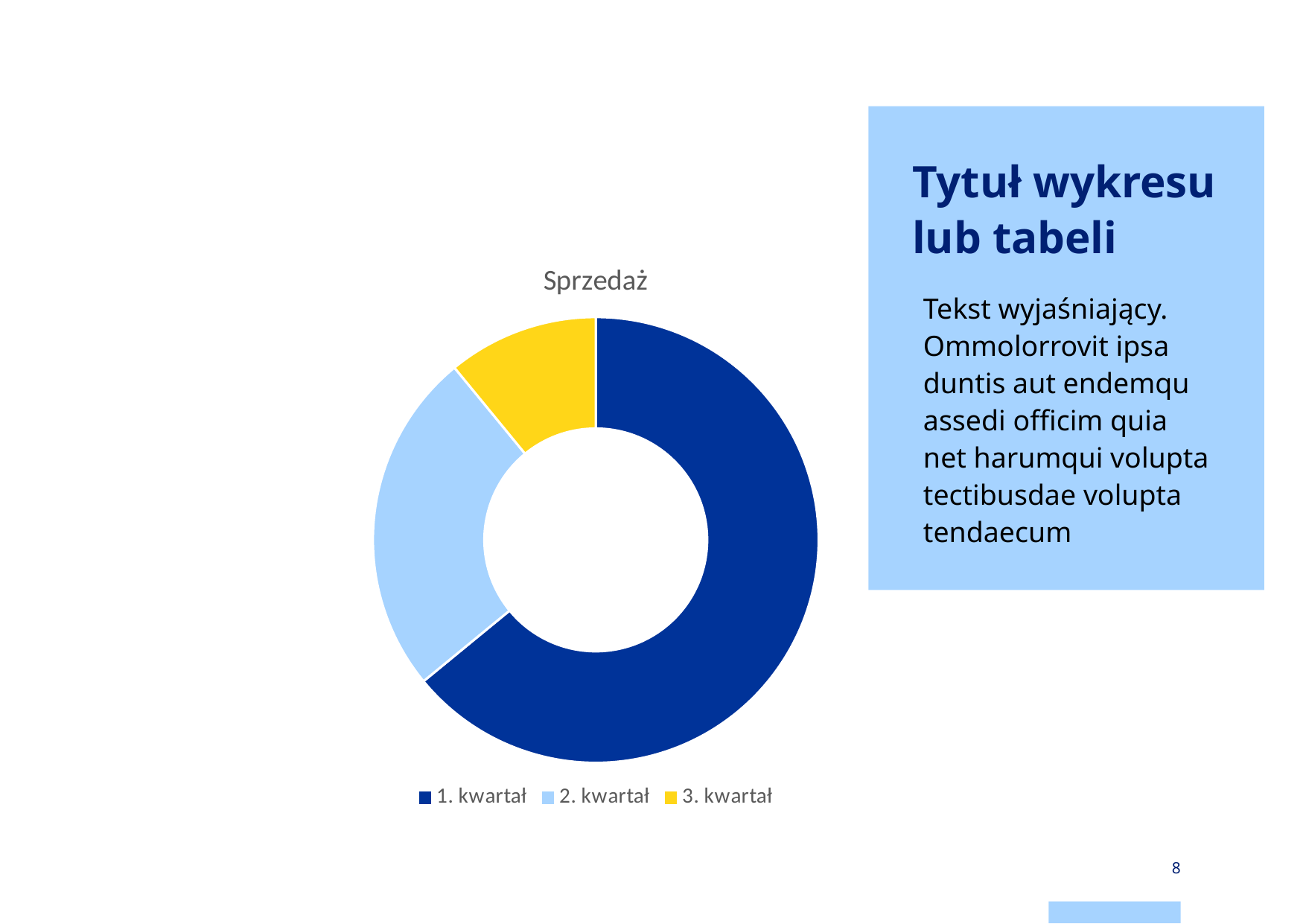
What is the title of the chart? Sprzedaż Which is larger, the slice for 2. kwartał or the slice for 3. kwartał? 2. kwartał Which is larger, the slice for 1. kwartał or the slice for 2. kwartał? 1. kwartał What kind of chart is shown on the slide? doughnut chart Which category has the largest slice in the chart? 1. kwartał Which is smaller, the slice for 1. kwartał or the slice for 3. kwartał? 3. kwartał How many slices does the chart have? 3 Which category has the smallest slice in the chart? 3. kwartał Does the slice for 1. kwartał take up more or less than half of the chart? more What colour is the slice for 3. kwartał? yellow How many entries does the chart legend list? 3